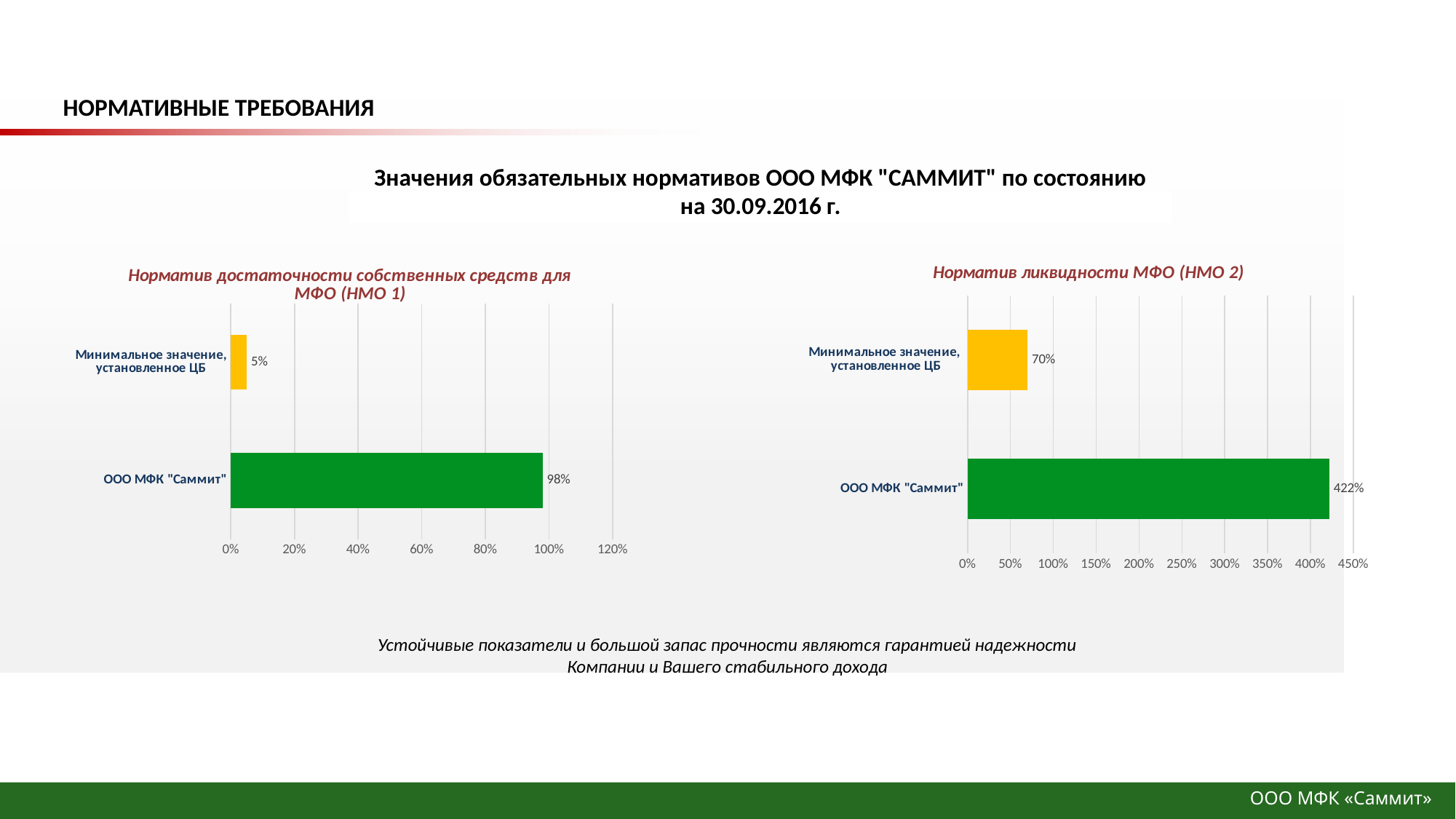
In the right chart (НМО 2), what is the value for ООО МФК "Саммит"? 422% In the right chart (НМО 2), what is the value for Минимальное значение, установленное ЦБ? 70% In the left chart (НМО 1), what is the difference between the value for ООО МФК "Саммит" and the minimum value set by the Central Bank? 93% What type of chart is the right chart (НМО 2)? Bar chart In the right chart (НМО 2), what is the difference between the value for ООО МФК "Саммит" and the minimum value set by the Central Bank? 352% How many categories are shown in the left chart (НМО 1)? 2 In the right chart (НМО 2), which is larger: the value for ООО МФК "Саммит" or the minimum value set by the Central Bank? ООО МФК "Саммит" In the left chart (НМО 1), what is the value for ООО МФК "Саммит"? 98% In the left chart (НМО 1), what is the value for Минимальное значение, установленное ЦБ? 5% In the right chart (НМО 2), which category has the lowest value? Минимальное значение, установленное ЦБ What is the title of the right chart? Норматив ликвидности МФО (НМО 2) In the left chart (НМО 1), which category has the highest value? ООО МФК "Саммит"